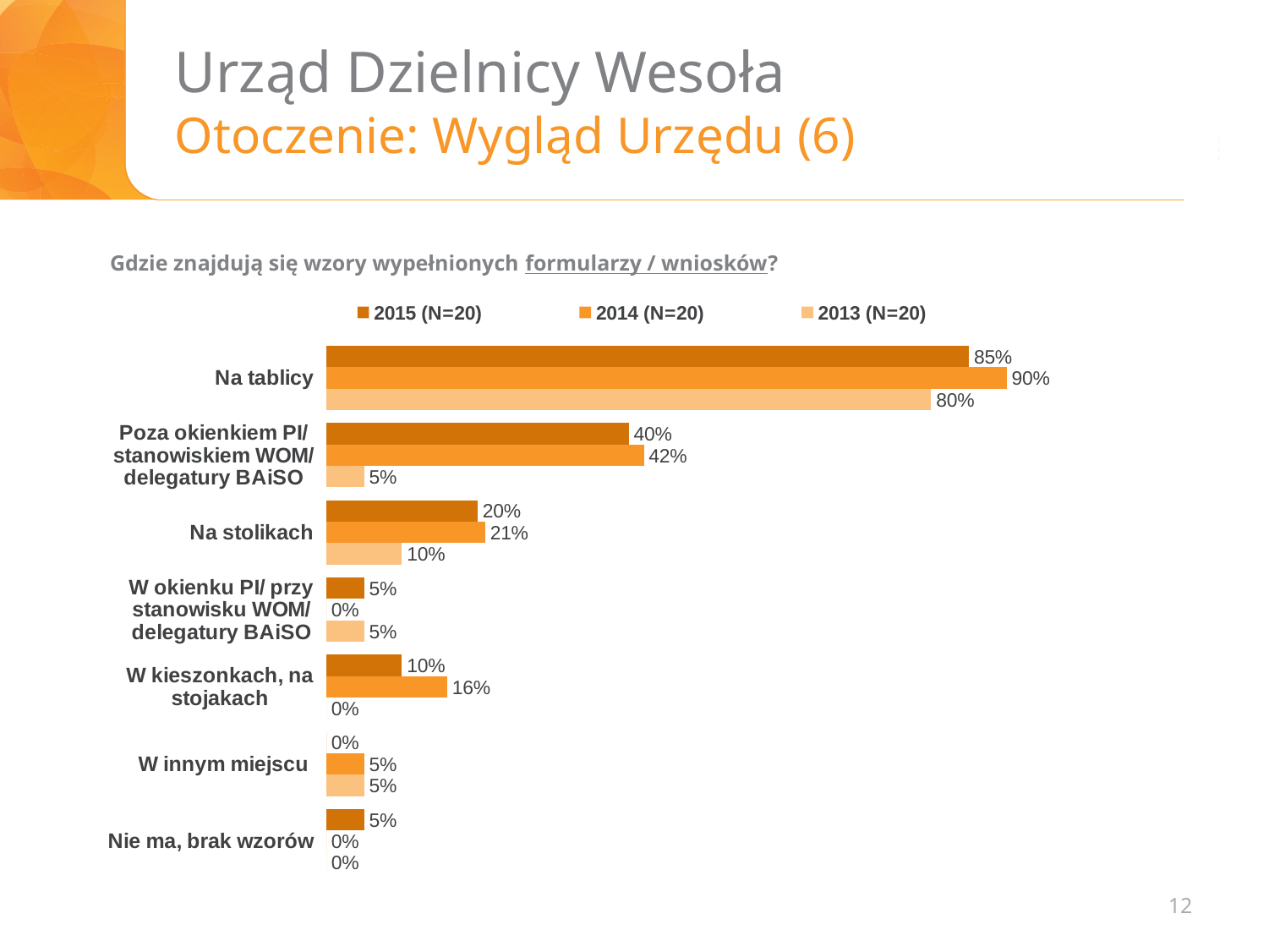
What is the value for "Na tablicy" in the 2014 (N=20) series? 90% How many categories are shown on the chart? 7 What is the difference between the 2014 (N=20) and 2015 (N=20) values for "Na tablicy"? 5% Which legend entry is shown in the lightest shade of orange? 2013 (N=20) For "Na tablicy", which series has the larger value: 2015 (N=20) or 2013 (N=20)? 2015 (N=20) Which category has the highest value in the 2015 (N=20) series? Na tablicy Which category has the lowest value in the 2015 (N=20) series? W innym miejscu What is the difference between the 2014 (N=20) and 2013 (N=20) values for "Poza okienkiem PI/ stanowiskiem WOM/ delegatury BAiSO"? 37% How many series does the legend list? 3 What is the value for "W kieszonkach, na stojakach" in the 2014 (N=20) series? 16% What is the value for "Na stolikach" in the 2013 (N=20) series? 10% What kind of chart is shown on the slide? bar chart